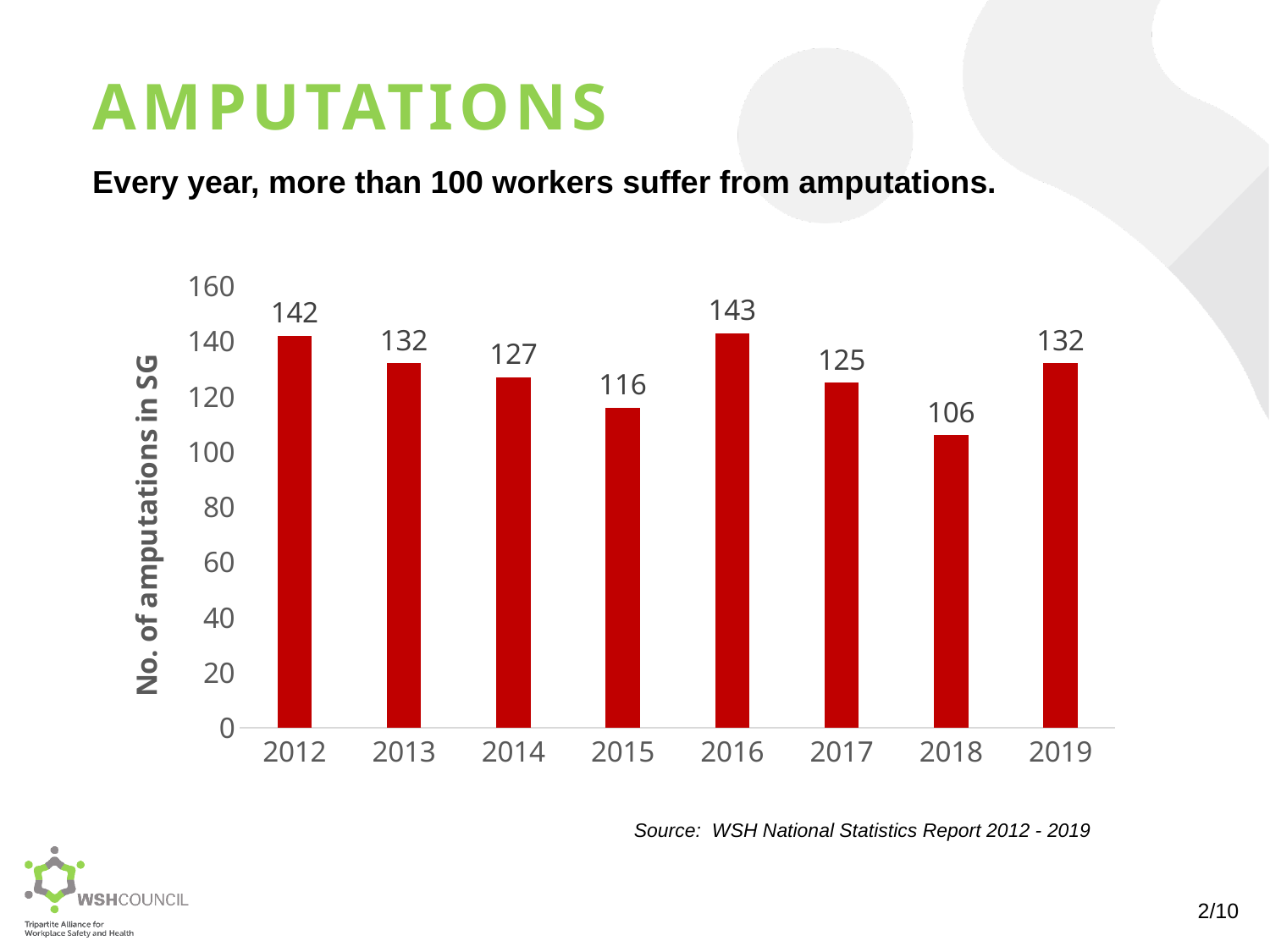
Which year has the lowest number of amputations? 2018 What is the label on the y axis of the chart? No. of amputations in SG Is the value for 2019 greater or less than 120? greater Do the values rise or fall from 2012 to 2015? Fall How many years are shown on the x axis of the chart? 8 What is the difference between the number of amputations in 2016 and 2018? 37 What kind of chart is shown on the slide? Bar chart Which year had more amputations, 2014 or 2017? 2014 Which year has the highest number of amputations? 2016 What is the number of amputations in SG for 2012? 142 What is the number of amputations in SG for 2015? 116 What is the number of amputations in SG for 2018? 106